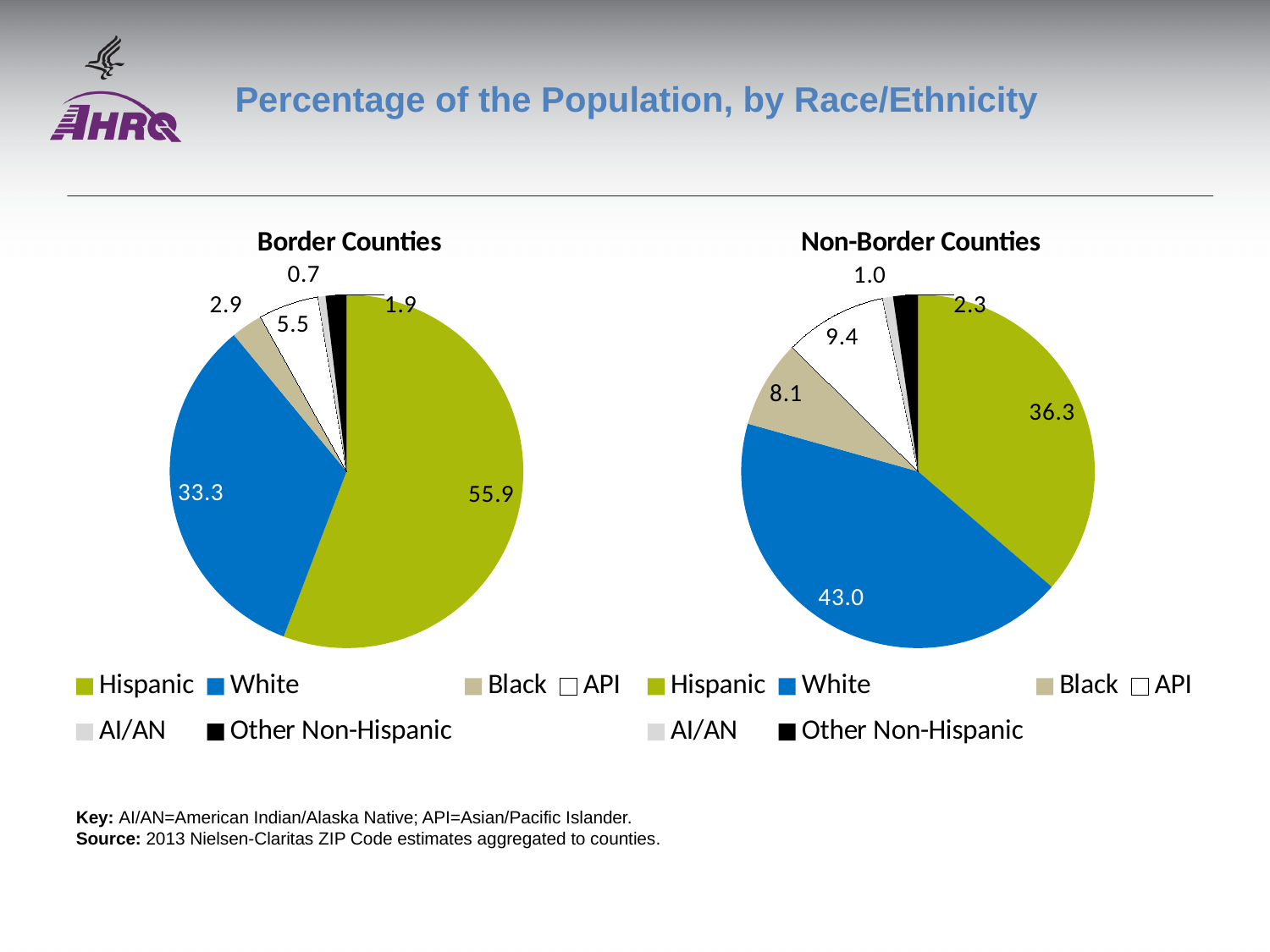
In the Border Counties chart, what is the value for Black? 2.9 What is the difference between the Hispanic share in Border Counties and the Hispanic share in Non-Border Counties? 19.6 In the Non-Border Counties chart, what is the difference between the White and Hispanic shares? 6.7 What type of chart is used on this slide? Pie chart In the Non-Border Counties chart, what percentage of the population is White? 43.0 Is the Black share larger in the Border Counties chart or the Non-Border Counties chart? Non-Border Counties In the Non-Border Counties chart, what is the value for API? 9.4 In the Non-Border Counties chart, which race/ethnicity group has the largest share? White How many slices does the Border Counties pie chart have? 6 In the Border Counties chart, which race/ethnicity group has the largest share? Hispanic In the Border Counties chart, what percentage of the population is Hispanic? 55.9 In the Border Counties chart, which race/ethnicity group has the smallest share? AI/AN